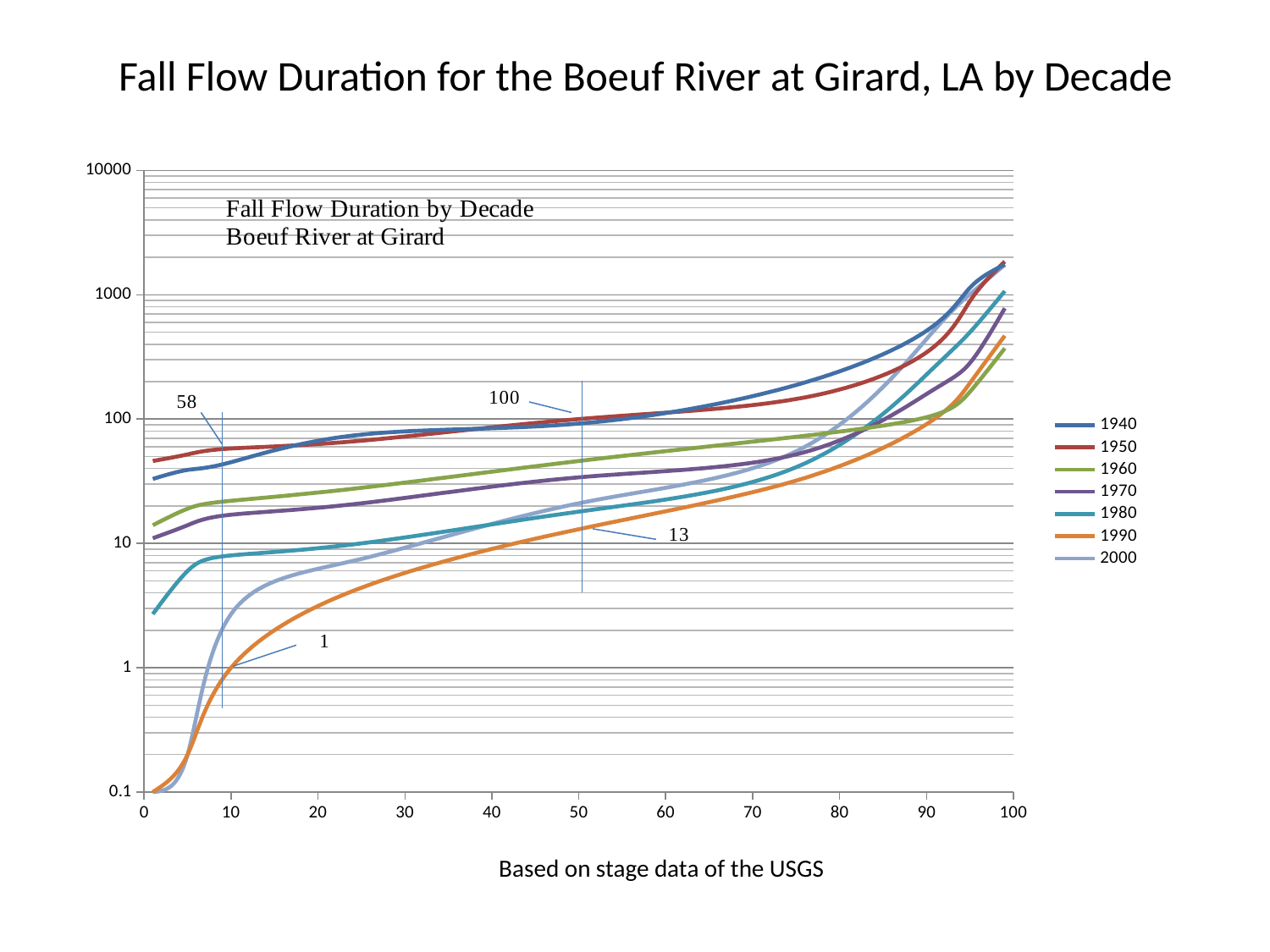
What kind of chart is shown on the slide? line chart Is the value of the 1990 line at 30 on the x axis greater or less than 10? less Is the value of the 1960 line at 50 on the x axis greater or less than 100? less Is the value of the 1980 line at 50 on the x axis greater or less than 10? greater What value is annotated on the 1990 line near the 10 mark on the x axis? 1 At 20 on the x axis, which series has the lowest value? 1990 What value is annotated on the 1990 line at the 50 mark on the x axis? 13 What is the title printed inside the chart area? Fall Flow Duration by Decade Boeuf River at Girard How many series does the legend list? 7 Which decades are listed in the legend? 1940, 1950, 1960, 1970, 1980, 1990, 2000 Do the values of the lines rise or fall as you move along the x axis from 0 to 100? rise At 50 on the x axis, which line is higher, 1960 or 1970? 1960